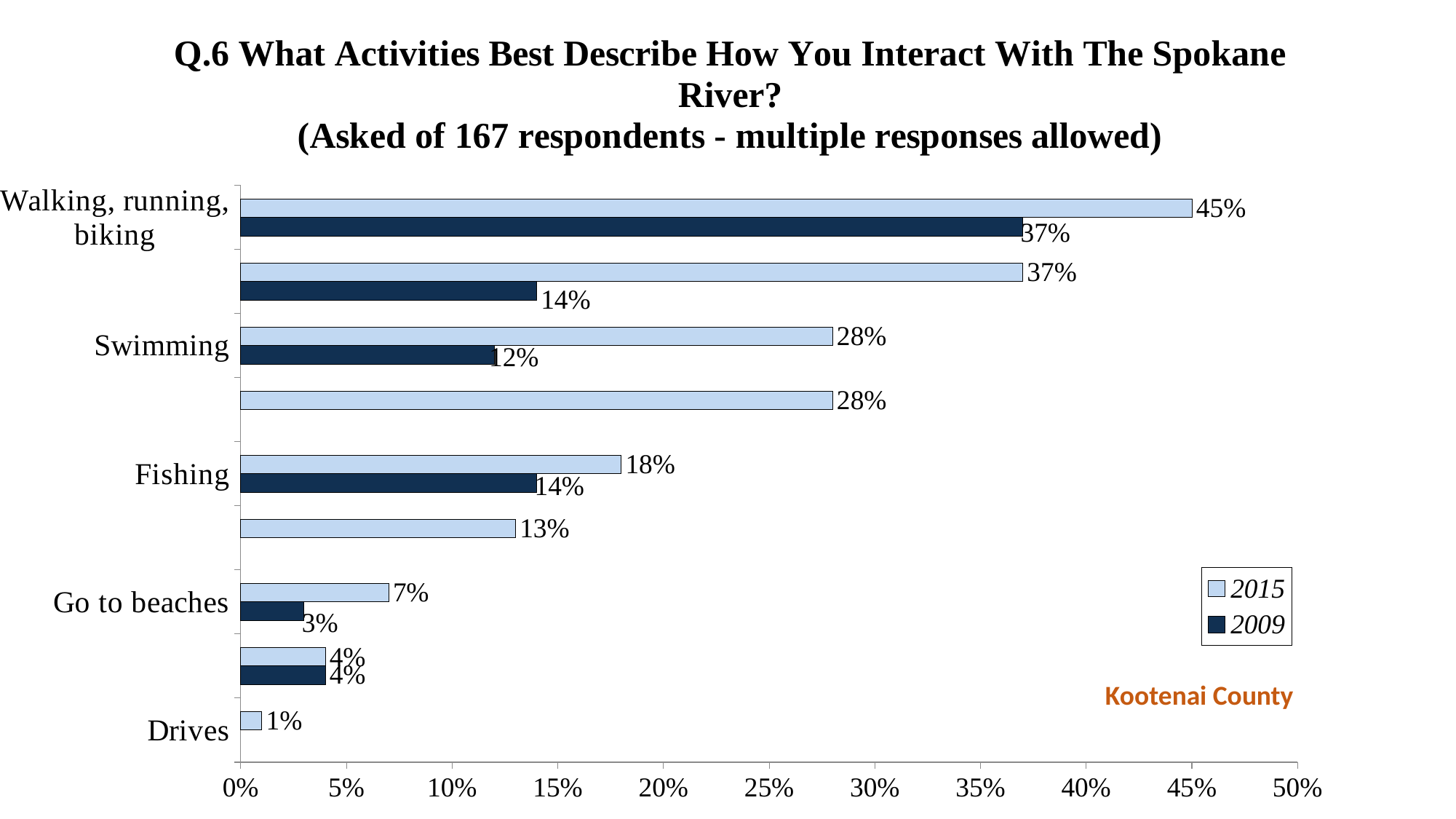
What is the difference between the 2015 and 2009 values for Swimming? 16% What kind of chart is shown on the slide? Bar chart What is the 2009 value for Swimming? 12% What is the 2015 value for Drives? 1% What is the difference between the 2015 and 2009 values for Walking, running, biking? 8% Which labeled activity has the highest 2015 value? Walking, running, biking What is the 2015 value for Fishing? 18% How many series does the legend list? 2 Which is larger for Fishing, the 2015 value or the 2009 value? 2015 What is the 2009 value for Go to beaches? 3% What is the 2015 value for Walking, running, biking? 45% Which labeled activity has the lowest 2015 value? Drives